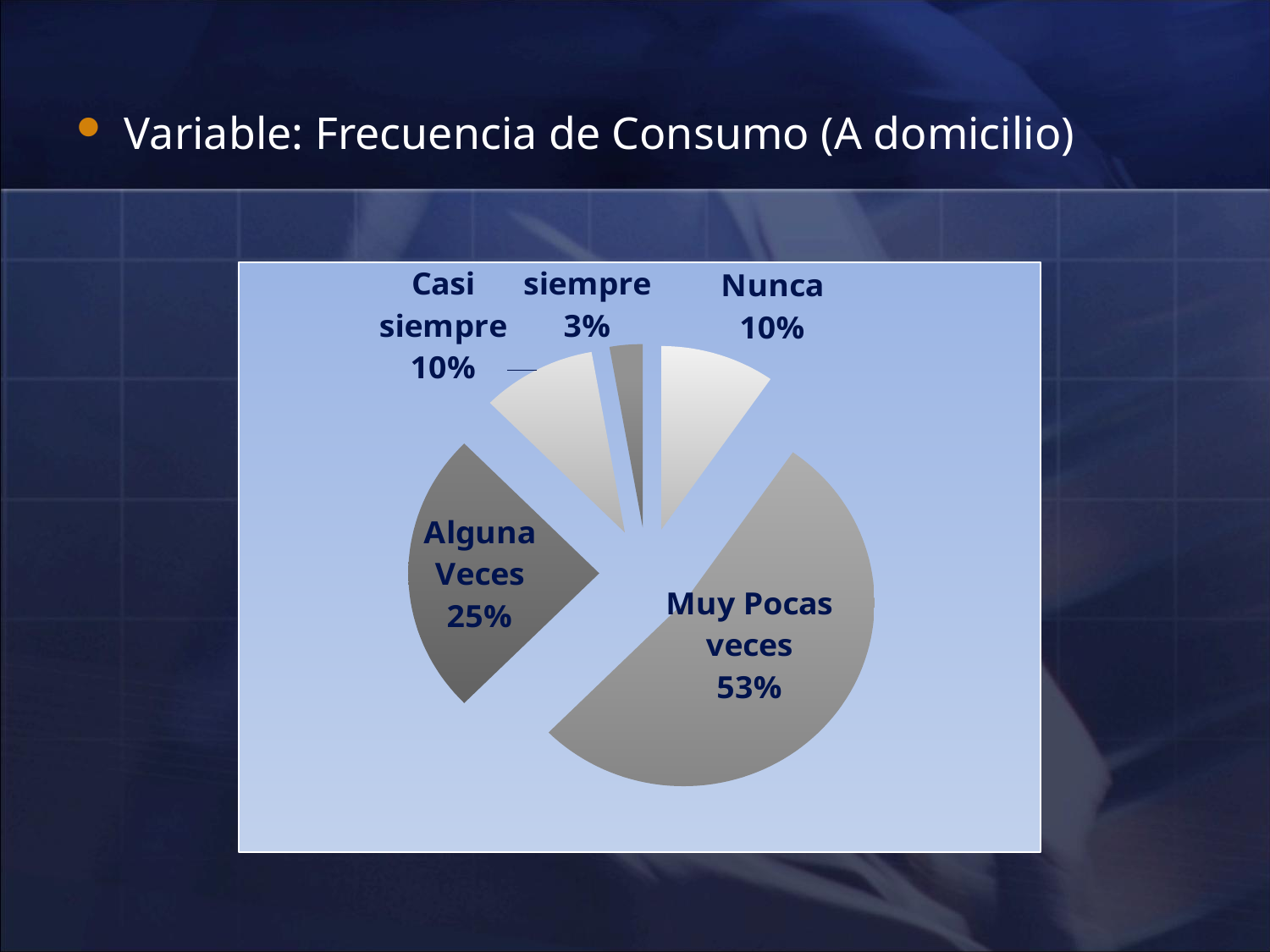
What percentage does the "Muy Pocas veces" slice represent? 53% What percentage does the "Alguna Veces" slice represent? 25% What is the difference in percentage points between "Muy Pocas veces" and "Alguna Veces"? 28 How many slices does the pie chart have? 5 Which category has the largest share of the pie? Muy Pocas veces Which category has the smallest share of the pie? siempre Which is larger, the share for "Alguna Veces" or the share for "Nunca"? Alguna Veces What percentage does the "Nunca" slice represent? 10% What kind of chart is shown on the slide? pie chart What percentage does the "siempre" slice represent? 3% What variable does the slide title say the chart is about? Frecuencia de Consumo (A domicilio) What percentage does the "Casi siempre" slice represent? 10%